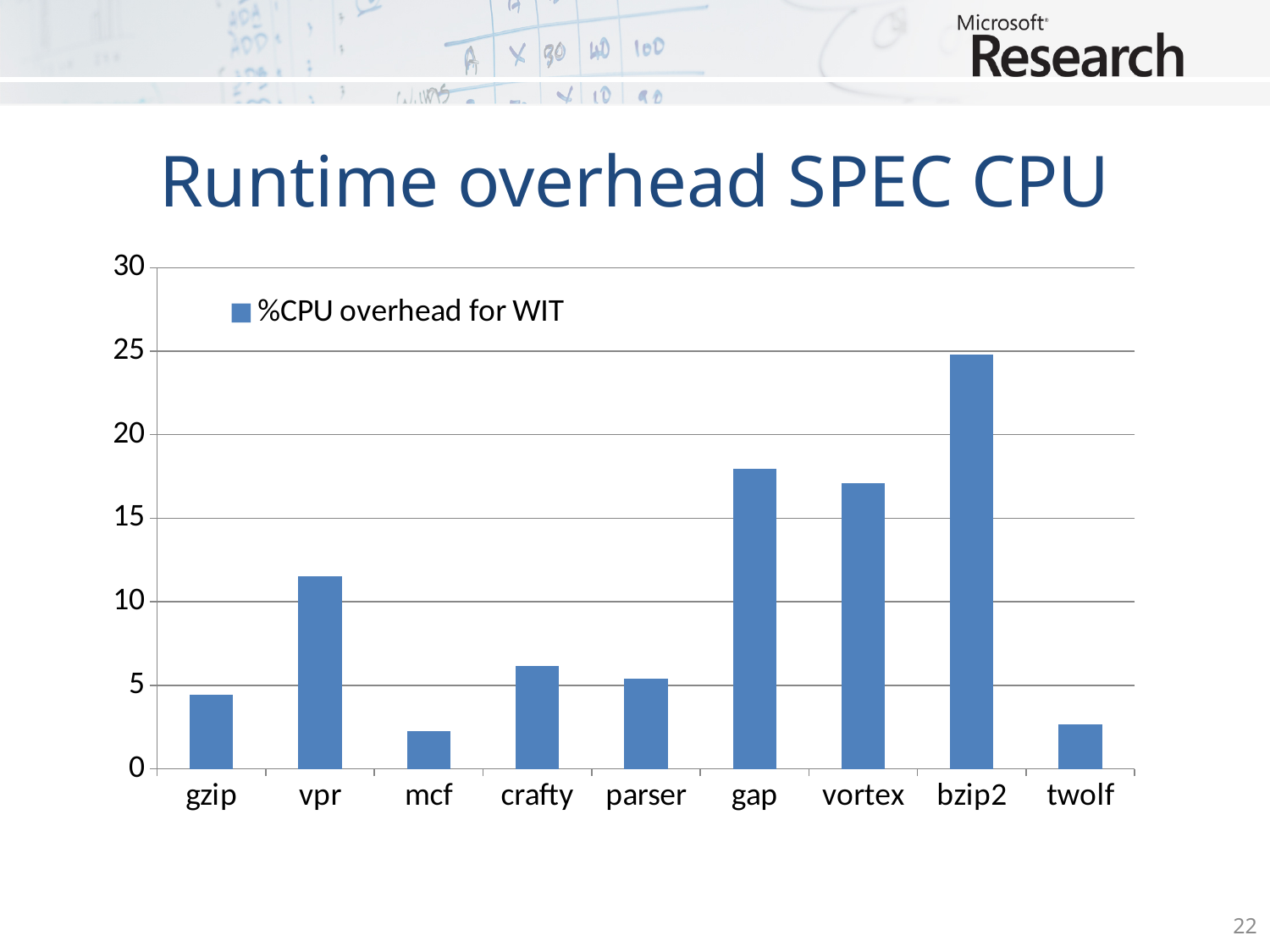
Is the value for vpr greater or less than 10? greater Which has a larger %CPU overhead for WIT, vpr or crafty? vpr How many series does the legend list? 1 Is the value for bzip2 greater or less than 20? greater Is the value for mcf greater or less than 5? less What is the title of the slide containing the chart? Runtime overhead SPEC CPU How many benchmarks (categories) are shown on the x axis? 9 What is the legend entry for the series plotted? %CPU overhead for WIT Which benchmark has the highest %CPU overhead for WIT? bzip2 What kind of chart is shown on the slide? bar chart